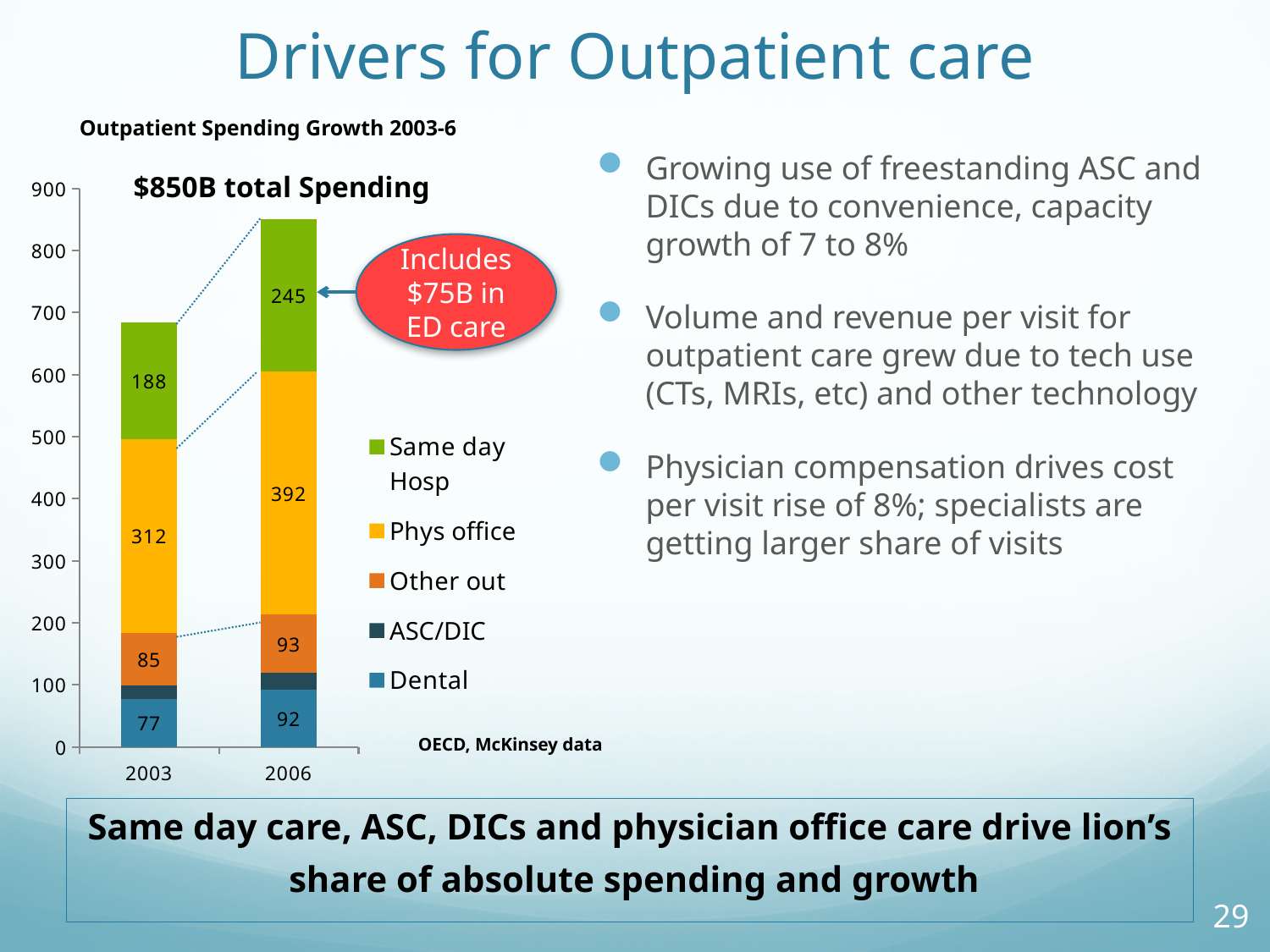
How many series does the legend list? 5 By how much did the Phys office value increase from 2003 to 2006? 80 What data source is cited below the chart? OECD, McKinsey data Is the Dental value larger in 2003 or in 2006? 2006 What is the value for Dental in 2006? 92 What is the value for Phys office in 2006? 392 Which series has the largest segment in the 2006 bar? Phys office What kind of chart is shown on the slide? Stacked bar chart What is the value for Other out in 2003? 85 What is the value for Same day Hosp in 2003? 188 What is the difference between the Same day Hosp values for 2006 and 2003? 57 Is the total height of the 2003 bar greater or less than 600? greater